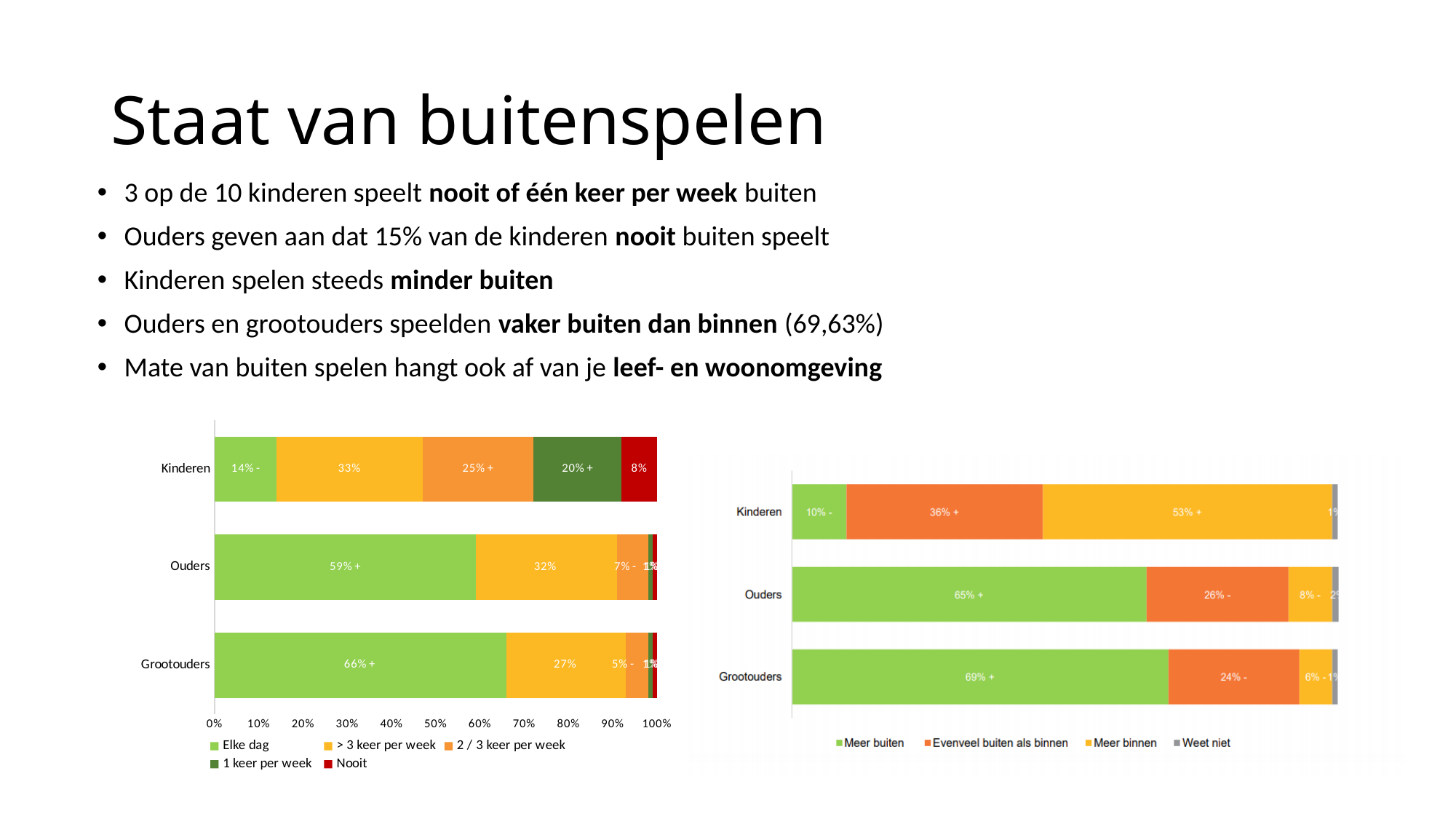
In the left chart, how many series does the legend list? 5 In the right chart, what is the 'Meer buiten' value for Grootouders? 69% In the left chart, what is the 'Nooit' value for Kinderen? 8% In the left chart, what is the difference between the 'Elke dag' values for Grootouders and Ouders? 7% In the right chart, is the 'Evenveel buiten als binnen' value larger for Kinderen or for Ouders? Kinderen What kind of chart is the left chart? Stacked bar chart In the right chart, how many categories are shown on the vertical axis? 3 In the left chart, what percentage of Kinderen play outside 'Elke dag'? 14% In the right chart, what is the 'Meer binnen' value for Kinderen? 53% In the right chart, which category has the lowest 'Meer buiten' value? Kinderen In the left chart, what is the '> 3 keer per week' value for Ouders? 32% In the left chart, which category has the highest 'Elke dag' value? Grootouders